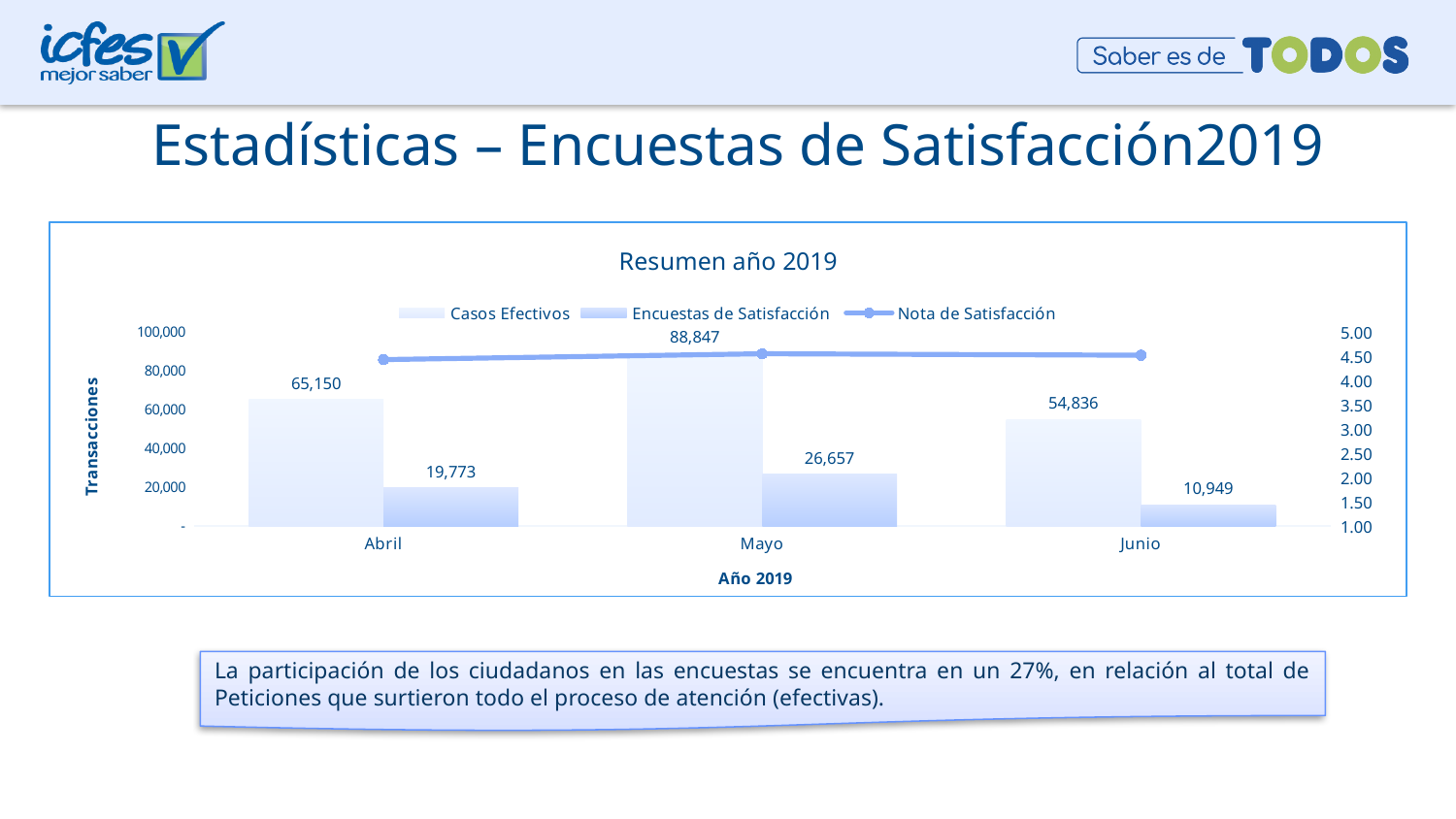
What is the value of Encuestas de Satisfacción for Junio? 10,949 Which month has the lowest value for Encuestas de Satisfacción? Junio How many months are shown on the x axis? 3 What is the value of Casos Efectivos for Abril? 65,150 What is the difference between Casos Efectivos and Encuestas de Satisfacción in Abril? 45,377 What is the label of the left vertical axis? Transacciones Which is larger: Encuestas de Satisfacción in Mayo or Encuestas de Satisfacción in Abril? Mayo What is the value of Casos Efectivos for Mayo? 88,847 What is the title of the chart? Resumen año 2019 Which month has the highest value for Casos Efectivos? Mayo Is the Nota de Satisfacción value for Mayo greater or less than 4.00 on the right-hand axis? greater How many series does the legend list? 3